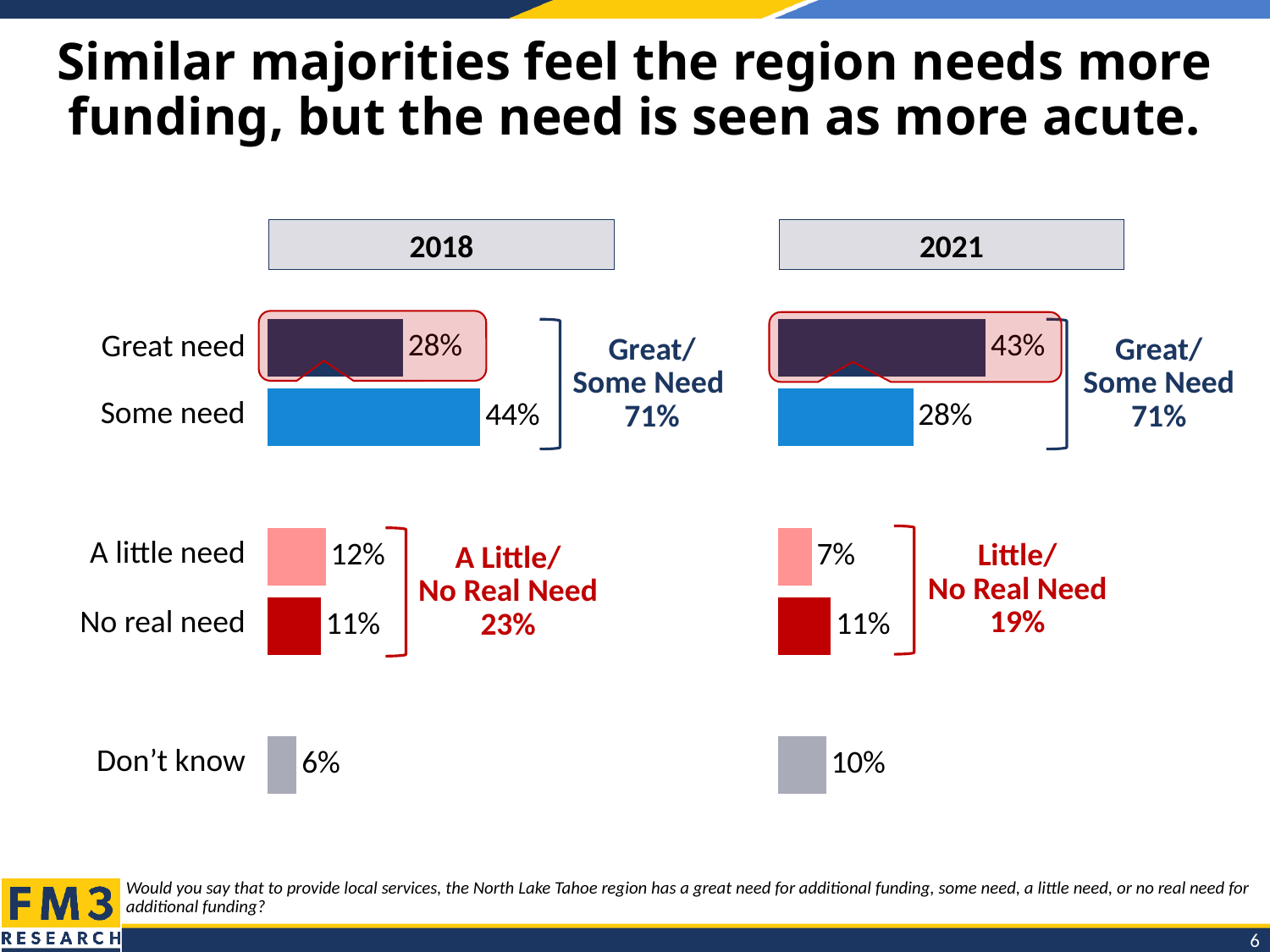
What is the difference between the Great need values in the 2021 chart and the 2018 chart? 15 percentage points In the 2018 chart, what is the value for Great need? 28% In the 2021 chart, what is the value for Don't know? 10% In the 2021 chart, which category has the highest value? Great need What is the combined Great/Some Need percentage shown for the 2021 chart? 71% In the 2018 chart, what is the value for Some need? 44% In the 2018 chart, which category has the lowest value? Don't know How many categories are shown in the 2018 chart? 5 In the 2021 chart, which category has the lowest value? A little need What kind of chart is used on this slide? Bar chart In the 2021 chart, what is the value for Great need? 43% In the 2018 chart, which is larger: Some need or Great need? Some need